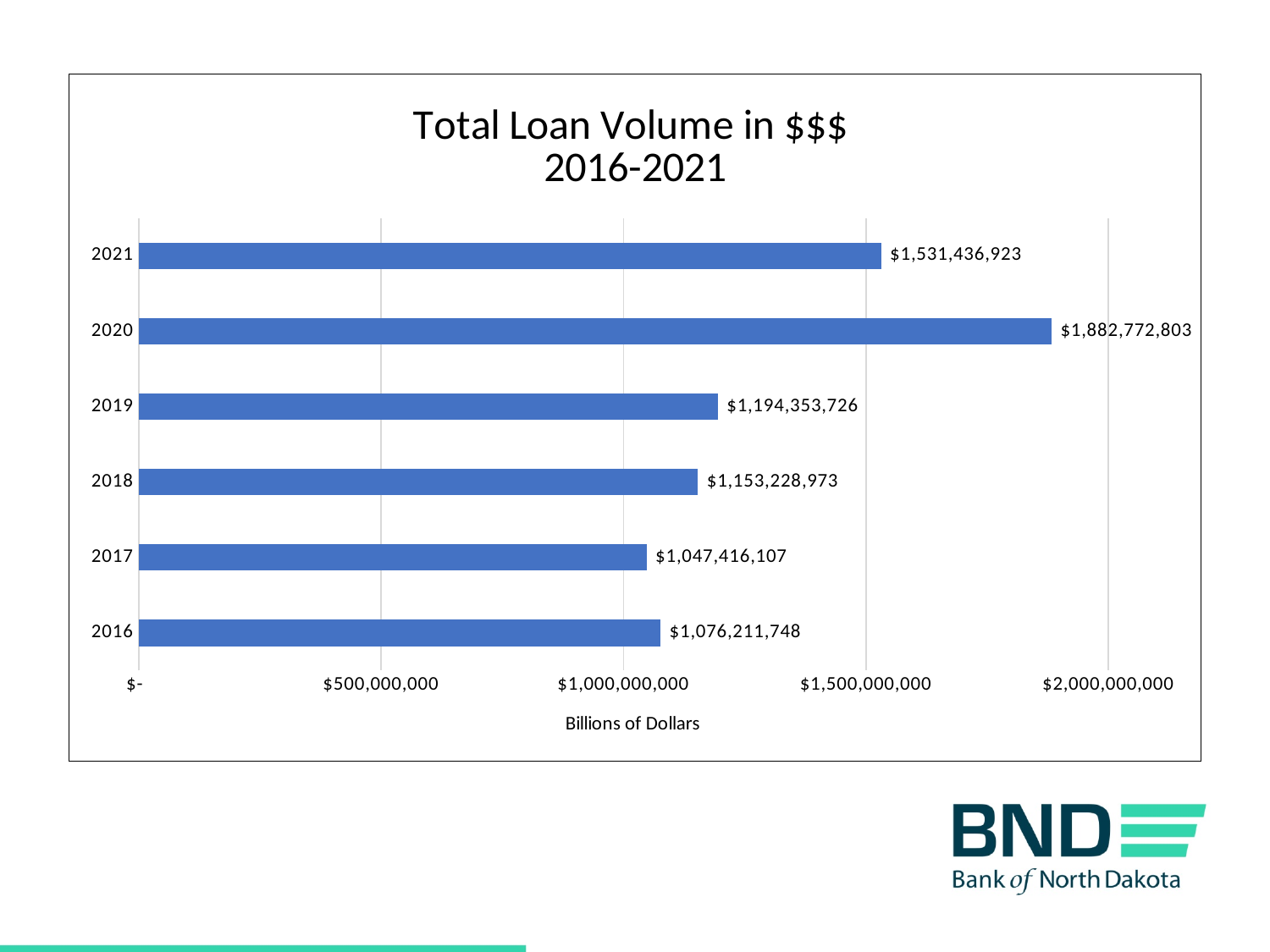
What was the total loan volume in 2019? $1,194,353,726 How much higher was the total loan volume in 2020 than in 2021? $351,335,880 Which year had a larger total loan volume, 2021 or 2019? 2021 What was the total loan volume in 2020? $1,882,772,803 Is the total loan volume for 2018 greater or less than $1,000,000,000? greater How many years are shown in the chart? 6 What was the total loan volume in 2016? $1,076,211,748 Which year had the lowest total loan volume? 2017 What is the difference between the total loan volume in 2019 and in 2018? $41,124,753 What kind of chart is shown on the slide? Bar chart Did the total loan volume rise or fall each year from 2017 to 2020? Rise Which year had the highest total loan volume? 2020